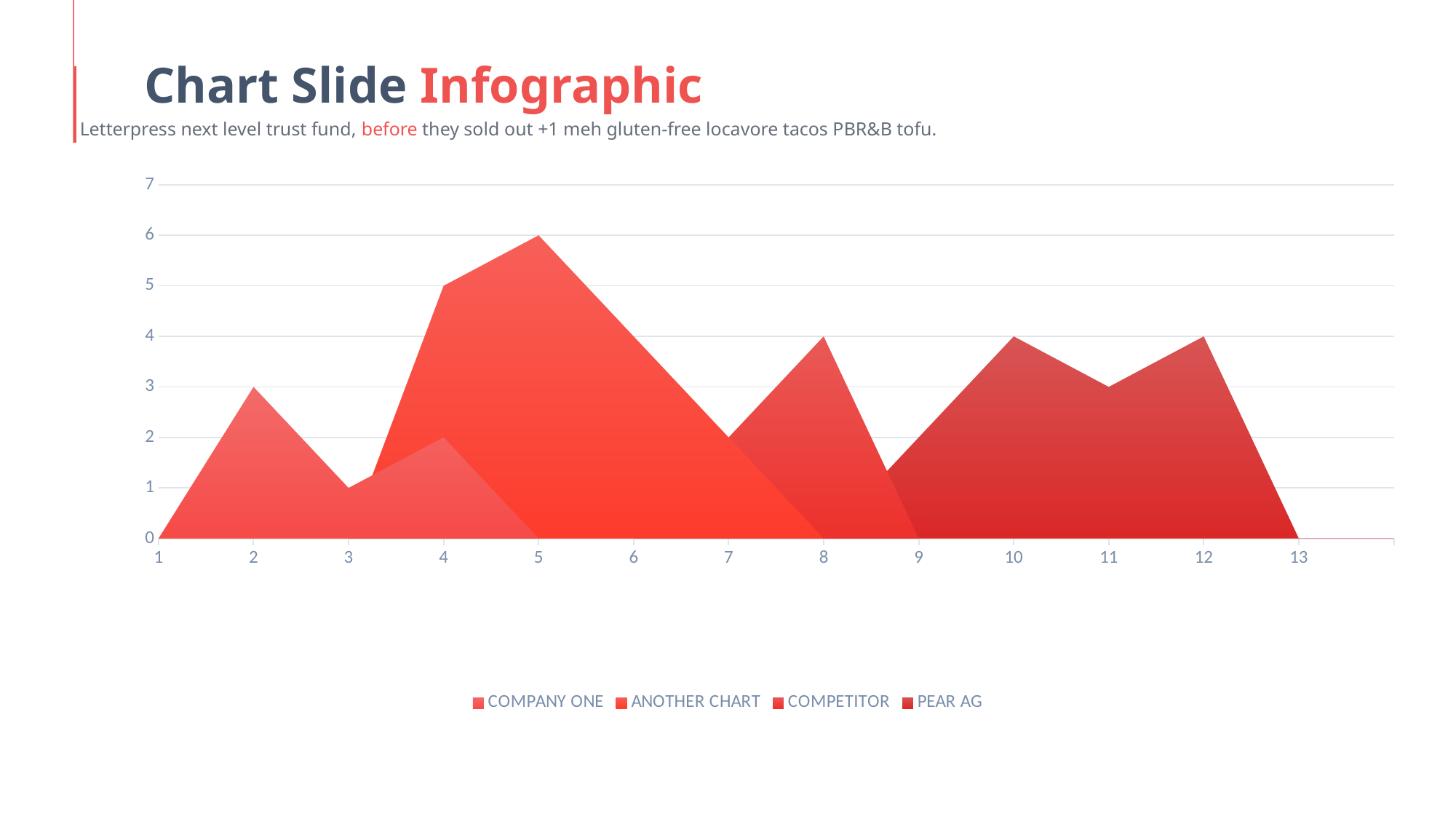
What is the value of the COMPETITOR series at point 8? 4 What is the difference between the value at point 5 (6) and the value at point 10 (4)? 2 Which series reaches the highest value on the chart? ANOTHER CHART What is the value of the COMPANY ONE series at point 2? 3 Which series is listed last in the legend? PEAR AG How many series does the legend list? 4 What kind of chart is shown on the slide? area chart Which is larger: the peak of ANOTHER CHART at point 5 or the peak of PEAR AG at point 10? ANOTHER CHART at point 5 How many points are labelled along the x axis? 13 What is the value of the PEAR AG series at point 11? 3 At which x-axis point does the chart reach its highest value? 5 What is the highest value reached by any series on the chart? 6